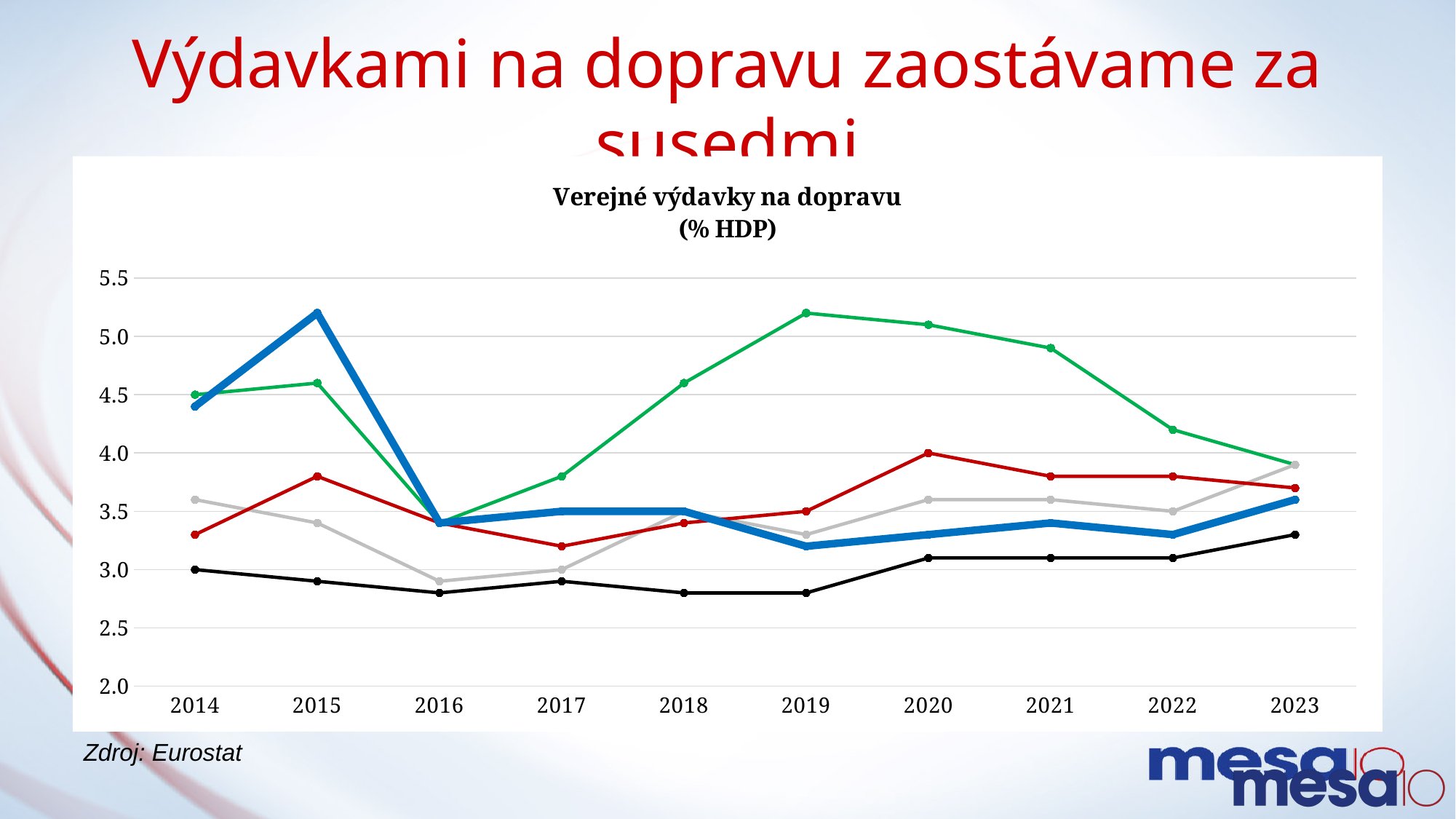
Is the value of the thick blue line in 2015 greater or less than 5.0? greater Is the value of the green line in 2019 greater or less than 5.0? greater Is the value of the black line in 2016 greater or less than 3.0? less Which line has the highest value in 2019? the green line In 2021, which is larger: the green line or the red line? the green line What is the title of the chart? Verejné výdavky na dopravu (% HDP) How many years are shown on the x axis of the chart? 10 Does the green line rise or fall from 2019 to 2023? fall Which line has the lowest value in 2014? the black line What kind of chart is shown on the slide? line chart How many lines are plotted on the chart? 5